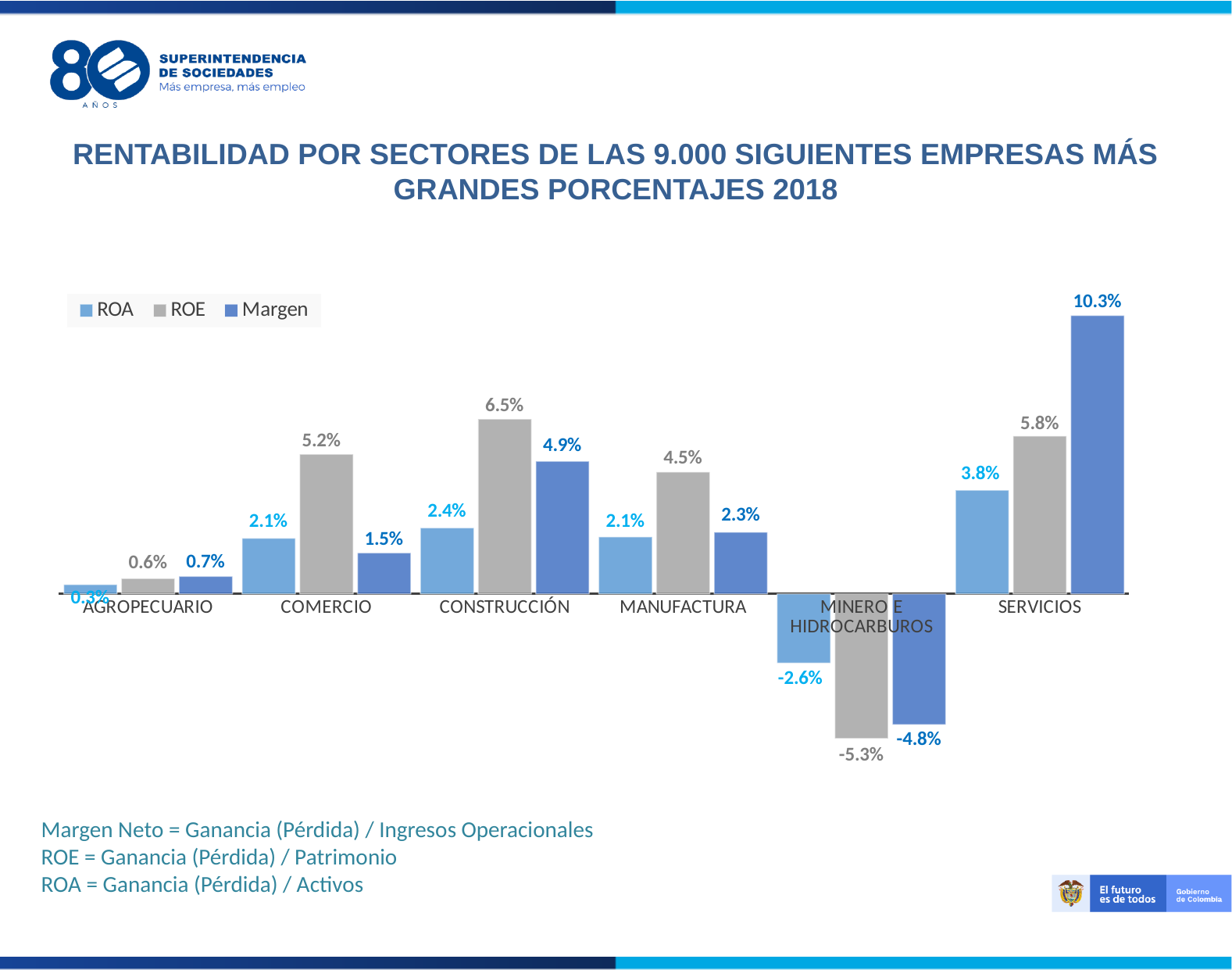
What is the Margen value for SERVICIOS? 10.3% What is the ROE value for CONSTRUCCIÓN? 6.5% Which sector has the highest ROE value? CONSTRUCCIÓN Which series is shown in grey in the legend? ROE What is the difference between the ROE and ROA values for SERVICIOS? 2.0% How many series does the legend list? 3 How many sectors are shown on the x axis of the chart? 6 What is the Margen value for COMERCIO? 1.5% Which sector has the lowest Margen value? MINERO E HIDROCARBUROS Which is larger for MANUFACTURA, the ROE value or the Margen value? ROE What is the ROA value for MINERO E HIDROCARBUROS? -2.6% What kind of chart is shown on the slide? Bar chart